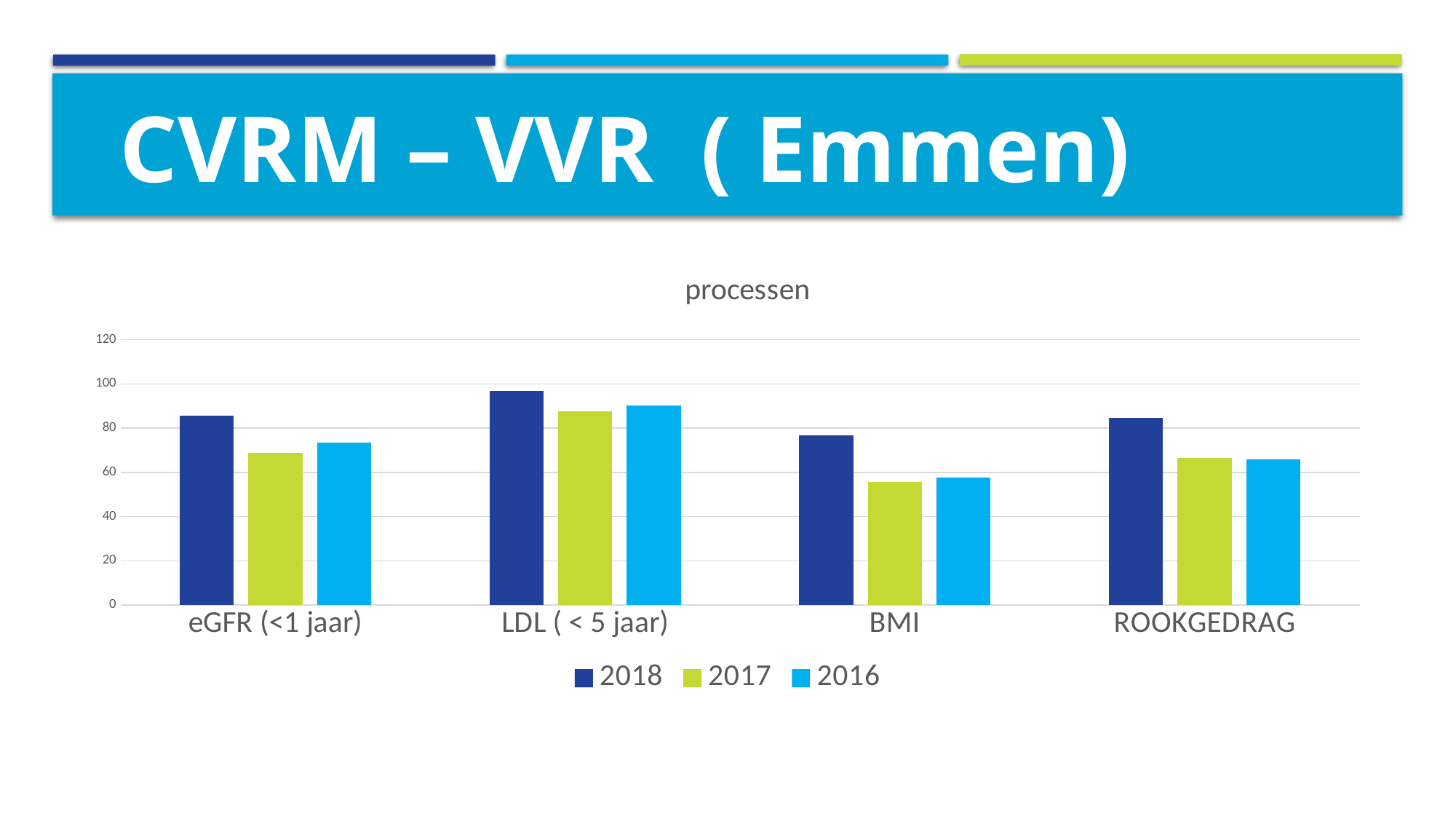
Is the 2018 value for eGFR (<1 jaar) greater or less than 80? greater Is the 2017 value for BMI greater or less than 60? less For eGFR (<1 jaar), which is larger: the 2018 value or the 2017 value? 2018 What is the title of the chart? processen Which category has the highest value for 2018? LDL ( < 5 jaar) Is the 2017 value for ROOKGEDRAG greater or less than 60? greater How many series does the legend list? 3 How many categories are shown on the x axis of the chart? 4 Which category has the lowest value for 2017? BMI What kind of chart is shown on the slide? bar chart Which is larger: the 2018 value for BMI or the 2018 value for ROOKGEDRAG? ROOKGEDRAG